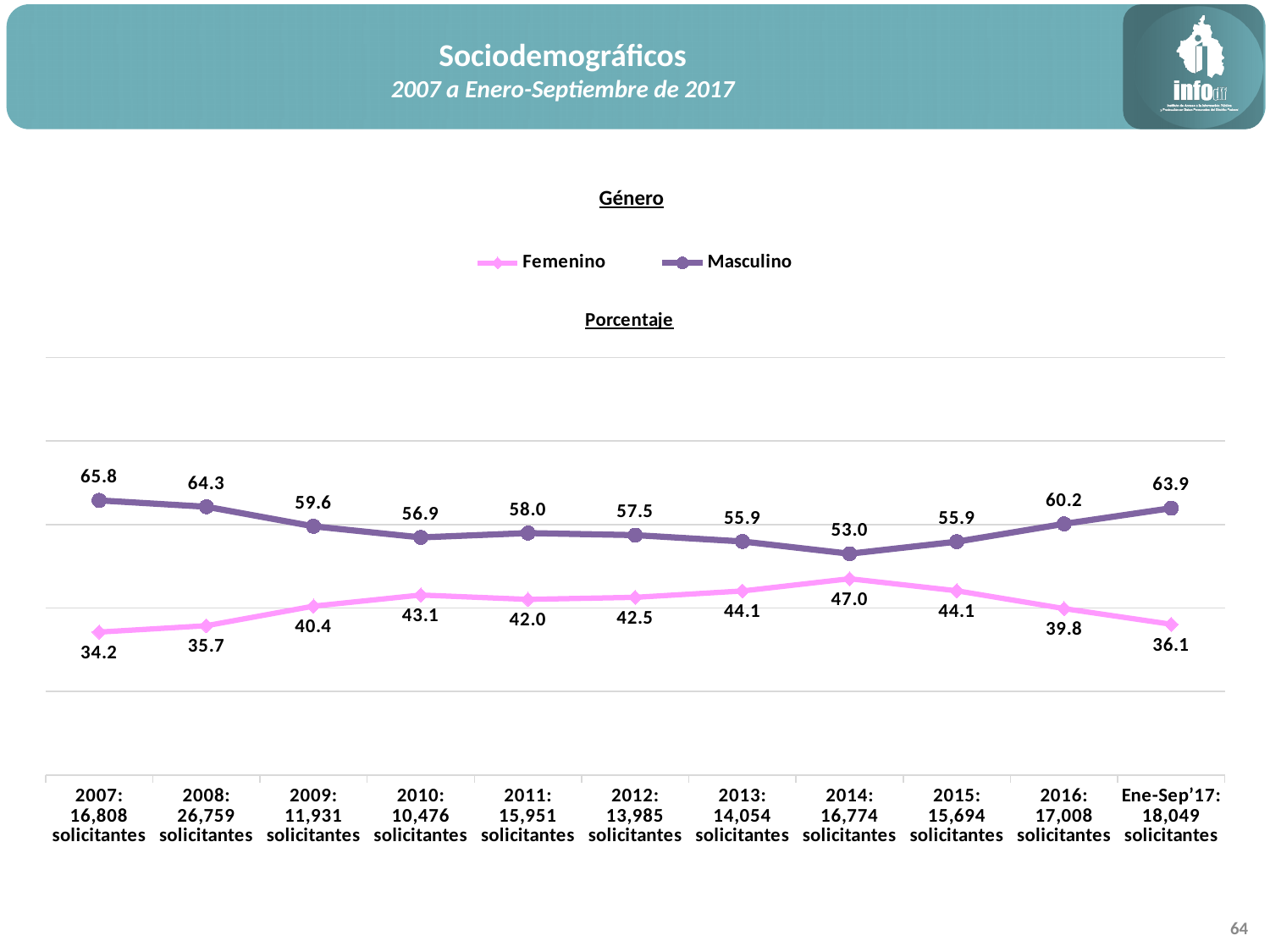
What is the difference between the Masculino and Femenino percentages in 2007? 31.6 What kind of chart is shown? Line chart How many solicitantes are listed for 2016 on the x axis? 17,008 Which series has the higher value in 2010, Femenino or Masculino? Masculino Does the Femenino percentage rise or fall from 2014 to Ene-Sep'17? Fall How many series does the legend list? 2 What is the Femenino percentage for Ene-Sep'17? 36.1 How many time periods are shown on the x axis? 11 In which year is the Masculino percentage lowest? 2014 What is the Masculino percentage for 2007? 65.8 In which year is the Femenino percentage highest? 2014 What is the Femenino percentage for 2014? 47.0